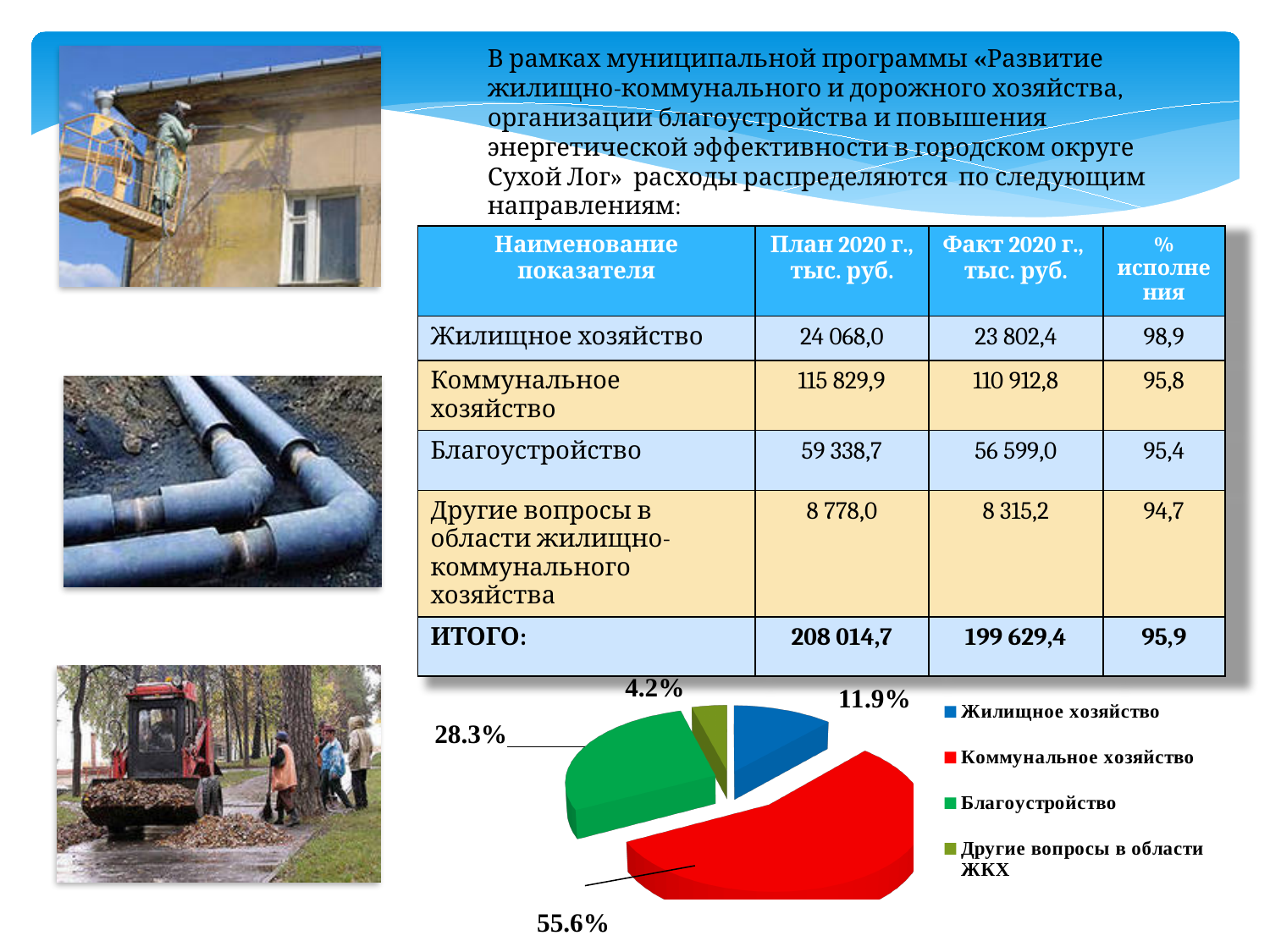
What share of the pie chart does Благоустройство have? 28.3% Which category has the smallest slice in the pie chart? Другие вопросы в области ЖКХ Which category has the largest slice in the pie chart? Коммунальное хозяйство In the pie chart, what is the difference between the shares of Коммунальное хозяйство and Благоустройство? 27.3% How many slices does the pie chart have? 4 In the pie chart, which is larger: Благоустройство or Жилищное хозяйство? Благоустройство What share of the pie chart does Другие вопросы в области ЖКХ have? 4.2% What share of the pie chart does Коммунальное хозяйство have? 55.6% What colour is the Коммунальное хозяйство slice in the pie chart? red How many entries does the pie chart legend list? 4 What kind of chart is shown at the bottom of the slide? pie chart